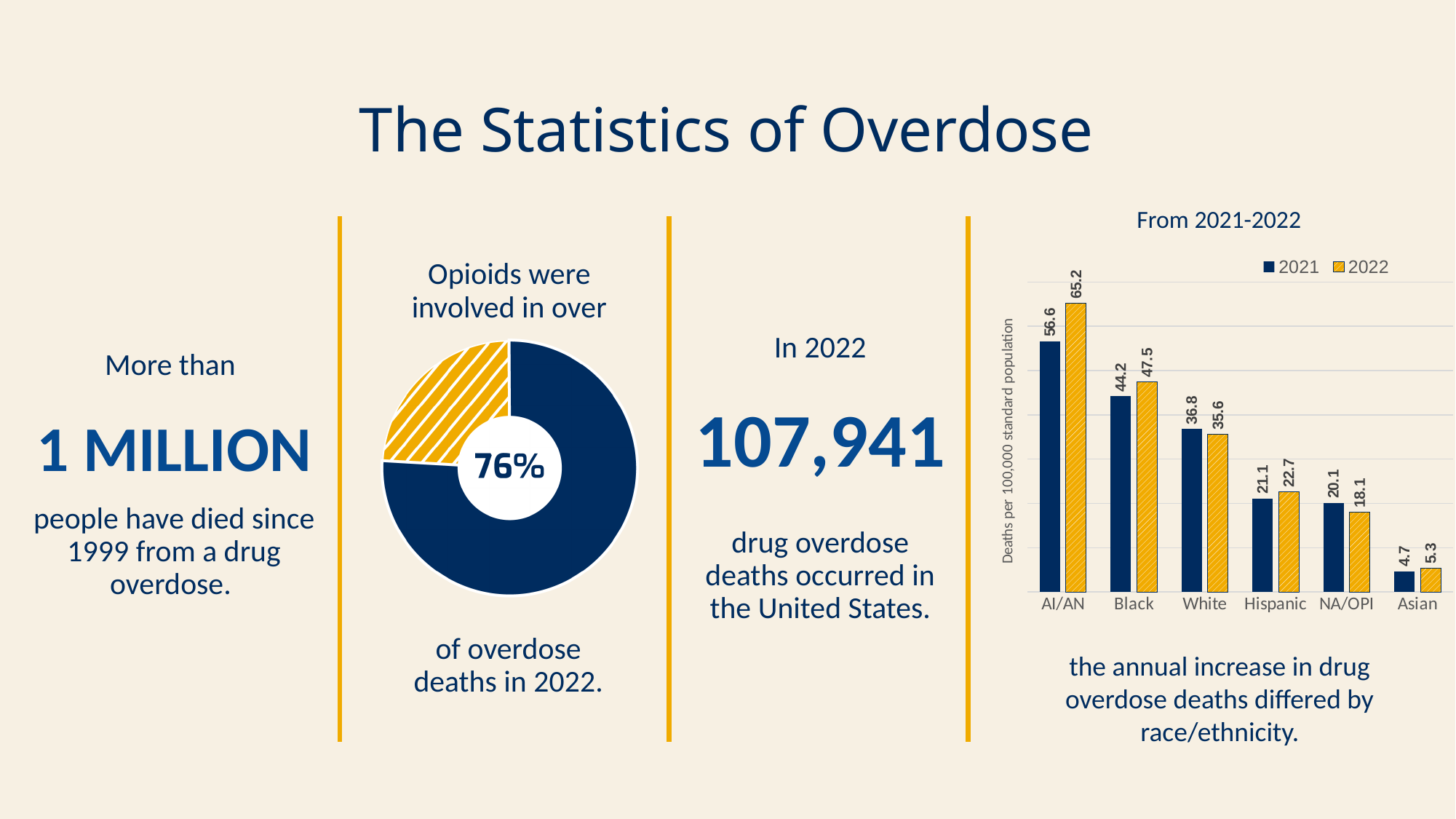
In the bar chart on the right, which category has the lowest 2021 value? Asian How many race/ethnicity categories are shown in the bar chart on the right? 6 In the bar chart on the right, which category has the highest 2022 value? AI/AN What kind of chart is the chart on the right of the slide? Bar chart In the donut chart in the middle of the slide, what share is shown for the labeled slice? 76% In the bar chart on the right, what is the 2022 value for AI/AN? 65.2 In the bar chart on the right, which is larger for White: the 2021 value or the 2022 value? 2021 In the bar chart on the right, what is the difference between the 2022 and 2021 values for AI/AN? 8.6 What is the y-axis label of the bar chart on the right? Deaths per 100,000 standard population How many series does the legend of the bar chart on the right list? 2 In the bar chart on the right, what is the 2021 value for Black? 44.2 In the bar chart on the right, what is the 2022 value for NA/OPI? 18.1